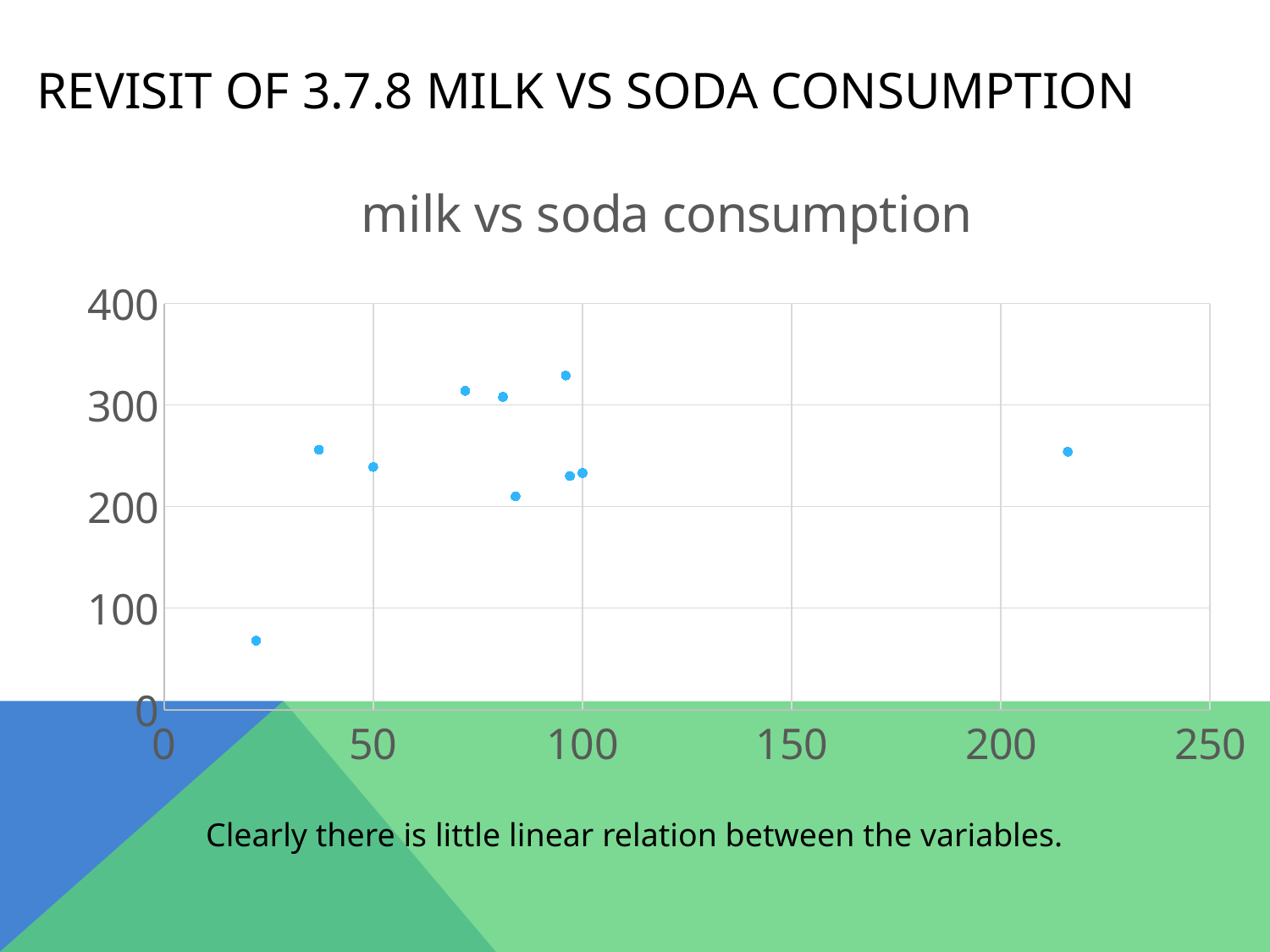
Is the y value of the lowest point on the chart greater or less than 100? less Is the x value of the rightmost point greater or less than 200? greater Is the y value of the highest point on the chart greater or less than 300? greater Is the y value of the point with the smallest x value greater or less than the y value of the point with the largest x value? less How many points have an x value greater than 150? 1 Do the y values show a clear rising or falling trend as x increases? no clear trend How many data points are plotted on the chart? 10 What is the title of the chart? milk vs soda consumption What kind of chart is shown on the slide? scatter plot What is the maximum value shown on the y axis? 400